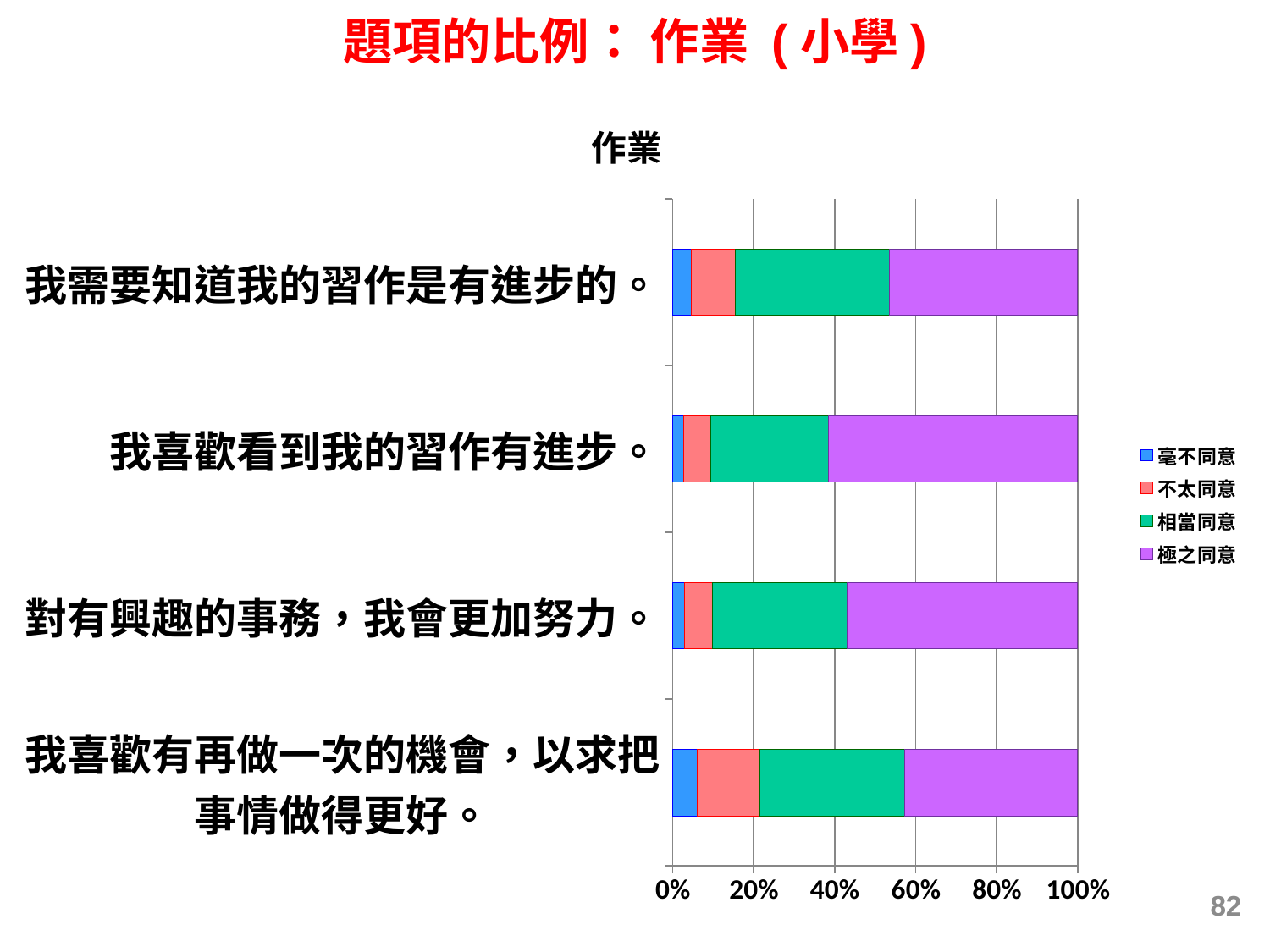
Is the 毫不同意 value for 我喜歡有再做一次的機會，以求把事情做得更好。 greater or less than 20%? less Is the 相當同意 segment larger for 我需要知道我的習作是有進步的。 or for 我喜歡看到我的習作有進步。? 我需要知道我的習作是有進步的。 What is the total of the stacked bar for 對有興趣的事務，我會更加努力。? 100% Which statement has the smallest 相當同意 segment? 我喜歡看到我的習作有進步。 Which statement has the largest 不太同意 segment? 我喜歡有再做一次的機會，以求把事情做得更好。 How many series does the legend list? 4 What is the title of the chart? 作業 What kind of chart is shown on the slide? bar chart Which legend entry is shown in purple? 極之同意 How many categories (statements) are plotted in the chart? 4 Which statement has the largest 極之同意 segment? 我喜歡看到我的習作有進步。 Is the 極之同意 value for 我需要知道我的習作是有進步的。 greater or less than 40%? greater